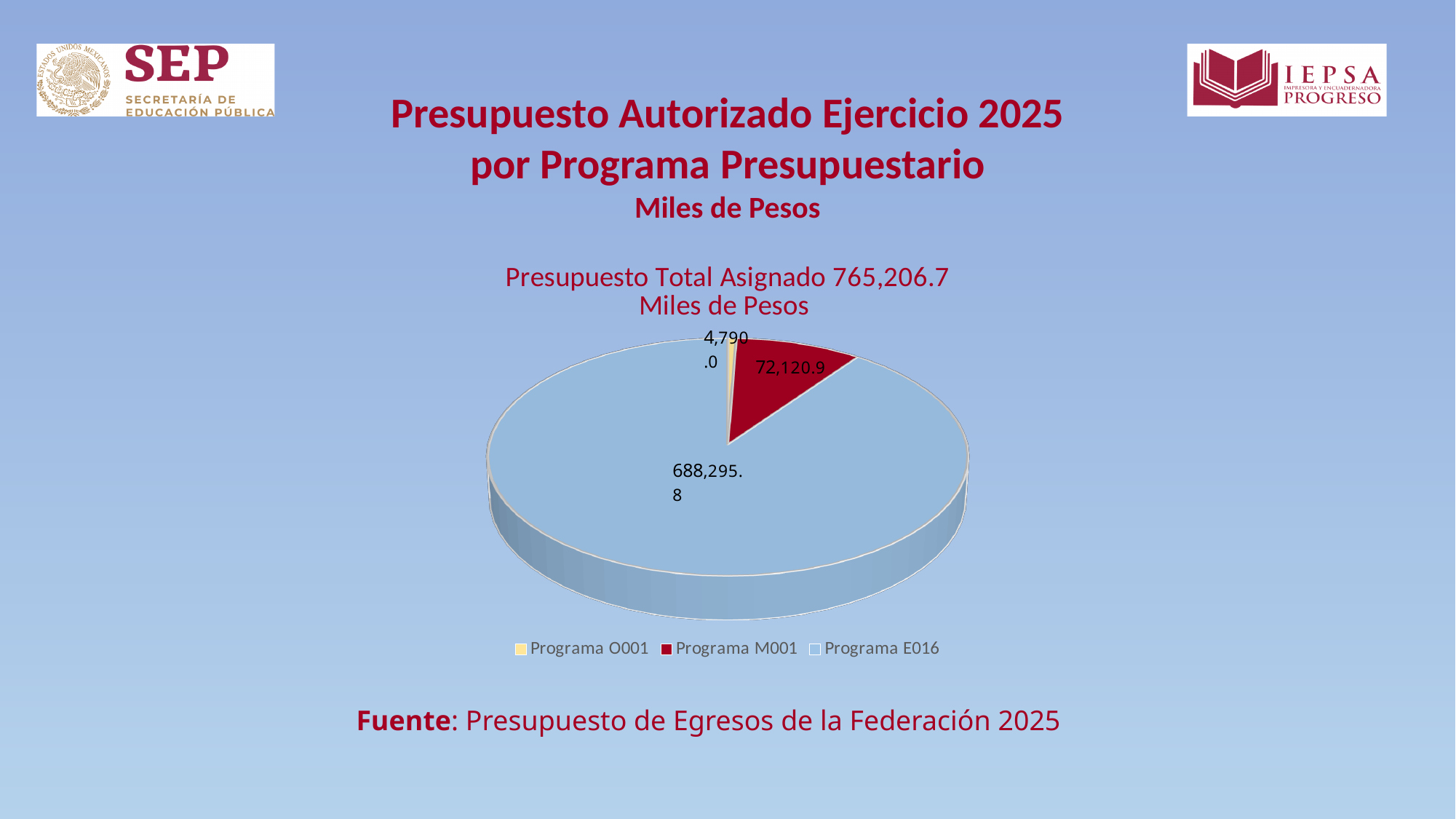
How many programs (slices) does the pie chart show? 3 What is the difference between the values for Programa E016 and Programa M001? 616,174.9 What is the value for Programa O001? 4,790.0 Which is larger, the value for Programa M001 or the value for Programa O001? Programa M001 What is the value for Programa E016? 688,295.8 What is the value for Programa M001? 72,120.9 Which program has the largest slice of the pie? Programa E016 What type of chart is shown on the slide? Pie chart What is the difference between the values for Programa M001 and Programa O001? 67,330.9 What is the total budget shown in the chart title (Presupuesto Total Asignado)? 765,206.7 Which program has the smallest slice of the pie? Programa O001 What colour is the slice for Programa M001? Dark red